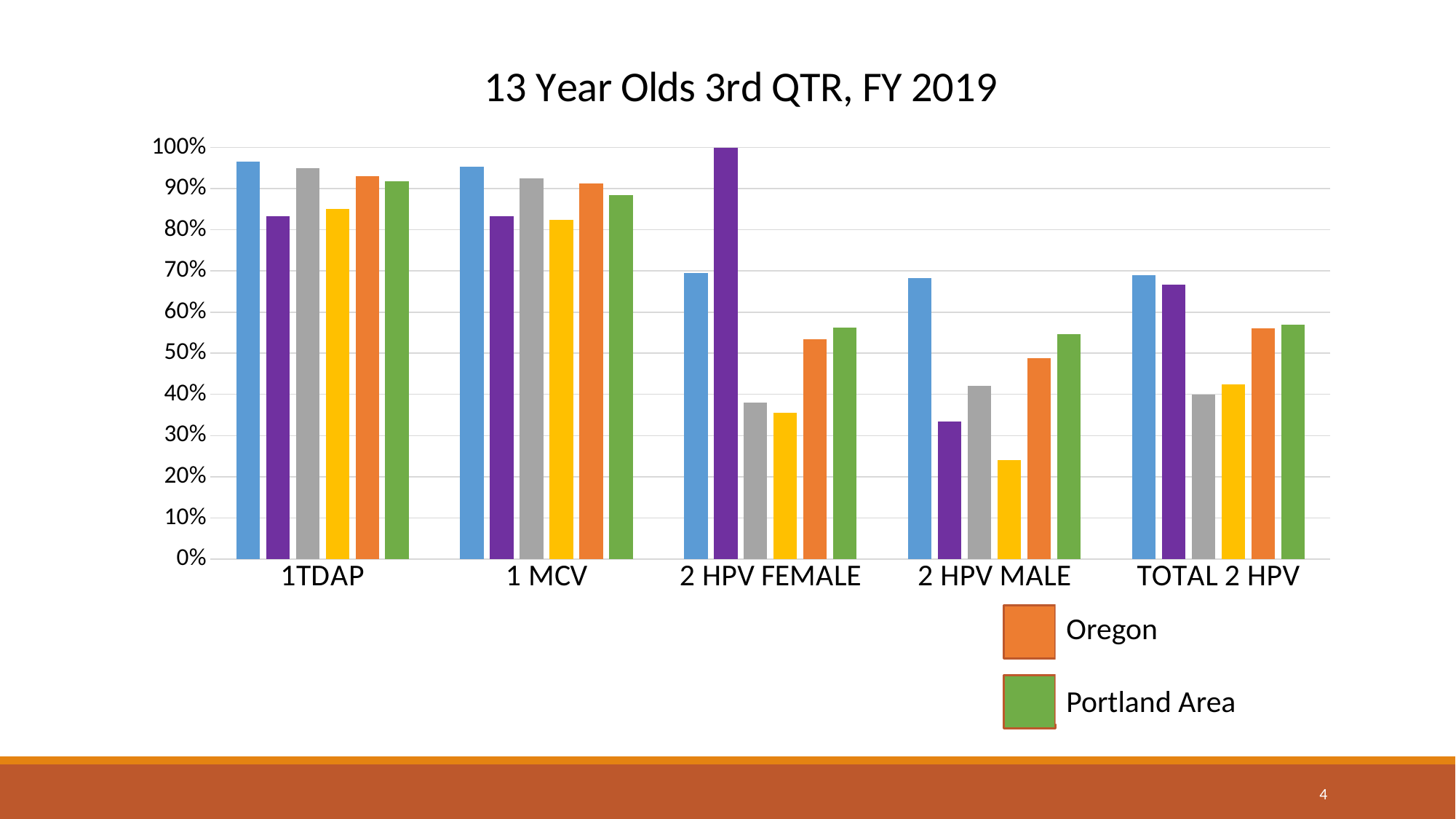
What type of chart is shown on the slide? bar chart Is the value for Portland Area in TOTAL 2 HPV greater or less than 50%? greater For 2 HPV MALE, which is larger: Oregon or Portland Area? Portland Area How many categories are shown on the x axis? 5 Which colour represents Portland Area in the legend? green Is the value for Oregon in 2 HPV MALE greater or less than 40%? greater How many series does the legend list? 2 Is the value for Portland Area in 1 MCV greater or less than 90%? less In which category is the Portland Area value highest? 1TDAP What is the title of the chart? 13 Year Olds 3rd QTR, FY 2019